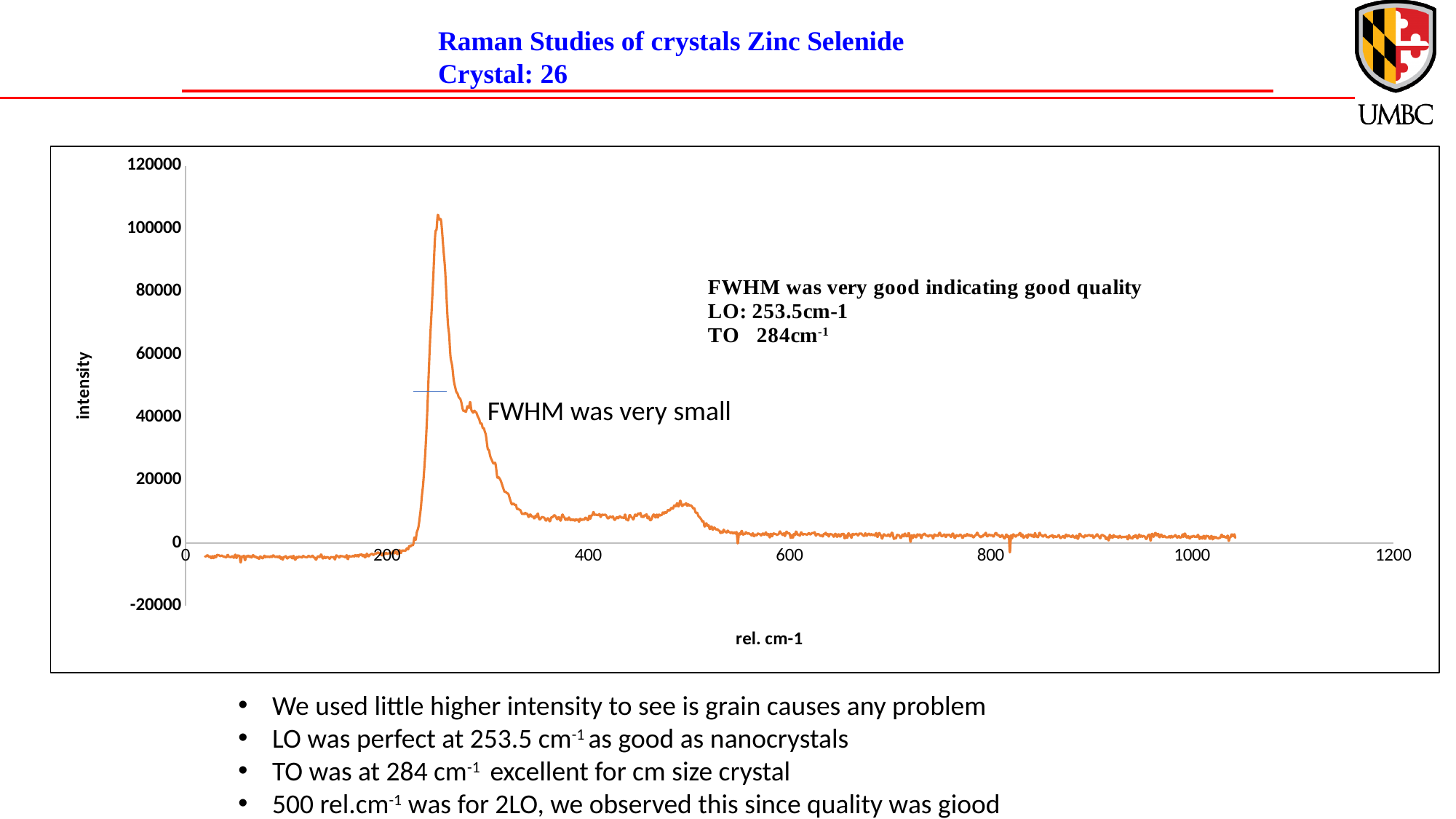
What is the label of the x axis of the chart? rel. cm-1 What is the label of the y axis of the chart? intensity Which peak is higher: the one near 250 rel. cm-1 or the one near 500 rel. cm-1? the one near 250 rel. cm-1 What is the highest value shown on the x axis of the chart? 1200 Is the maximum intensity of the main peak greater or less than 100000? greater How many data series are plotted in the chart? 1 Is the main peak of the spectrum located at an x value greater or less than 400 rel. cm-1? less Is the intensity of the signal at 1000 rel. cm-1 greater or less than 20000? less What kind of chart is shown on the slide? line chart